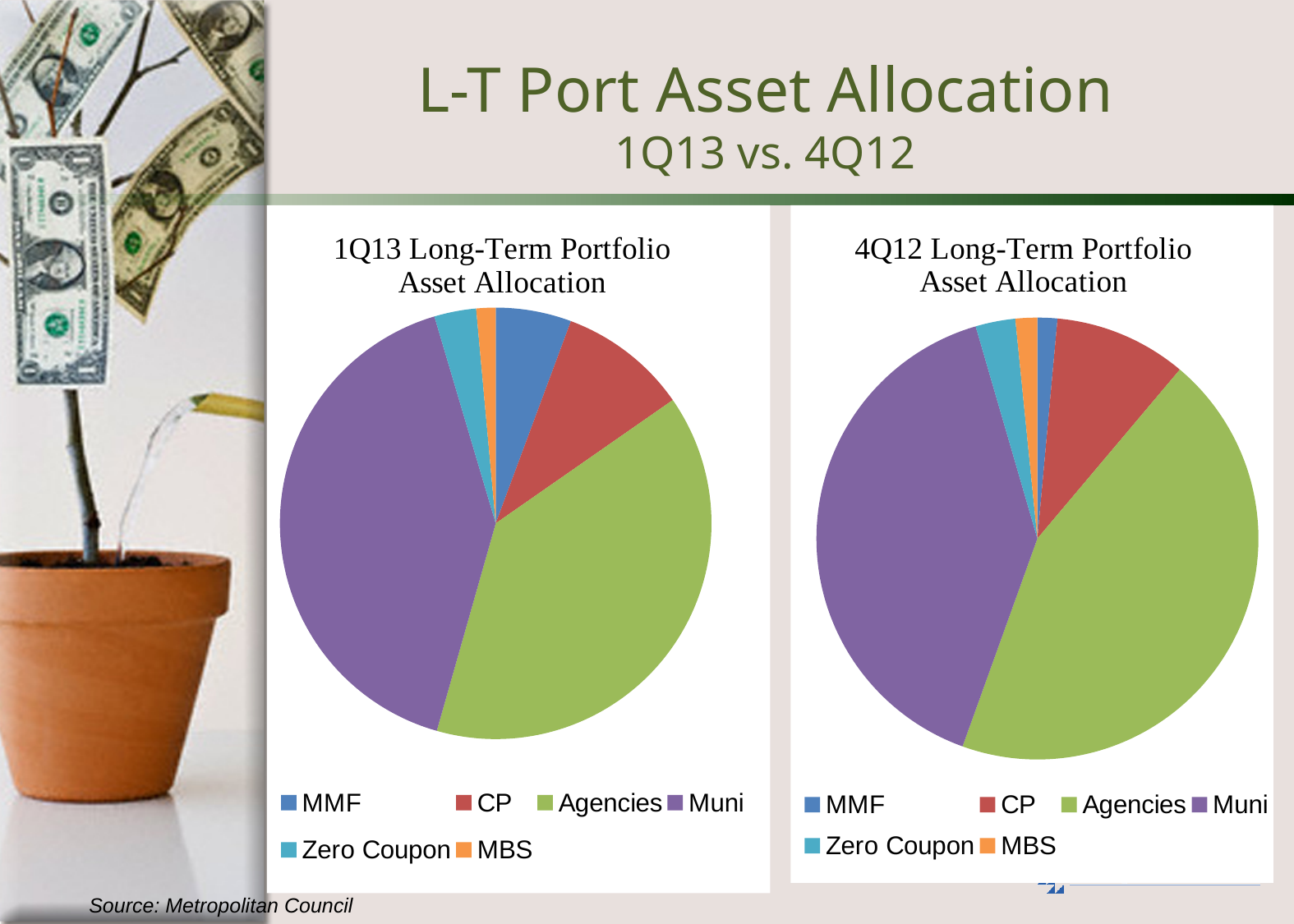
How many slices does the 4Q12 Long-Term Portfolio Asset Allocation pie chart have? 6 Is the MMF slice larger in the 1Q13 chart or in the 4Q12 chart? 1Q13 In the 1Q13 Long-Term Portfolio Asset Allocation chart, which category has the smallest slice? MBS What colour represents Agencies in the pie charts? Green How many entries does the legend of the 1Q13 Long-Term Portfolio Asset Allocation chart list? 6 What is the main title of the slide? L-T Port Asset Allocation What kind of chart is the 1Q13 Long-Term Portfolio Asset Allocation chart? Pie chart How many pie charts are shown on the slide? 2 In the 1Q13 Long-Term Portfolio Asset Allocation chart, which slice is larger, CP or MMF? CP In the 4Q12 Long-Term Portfolio Asset Allocation chart, which slice is larger, Agencies or CP? Agencies